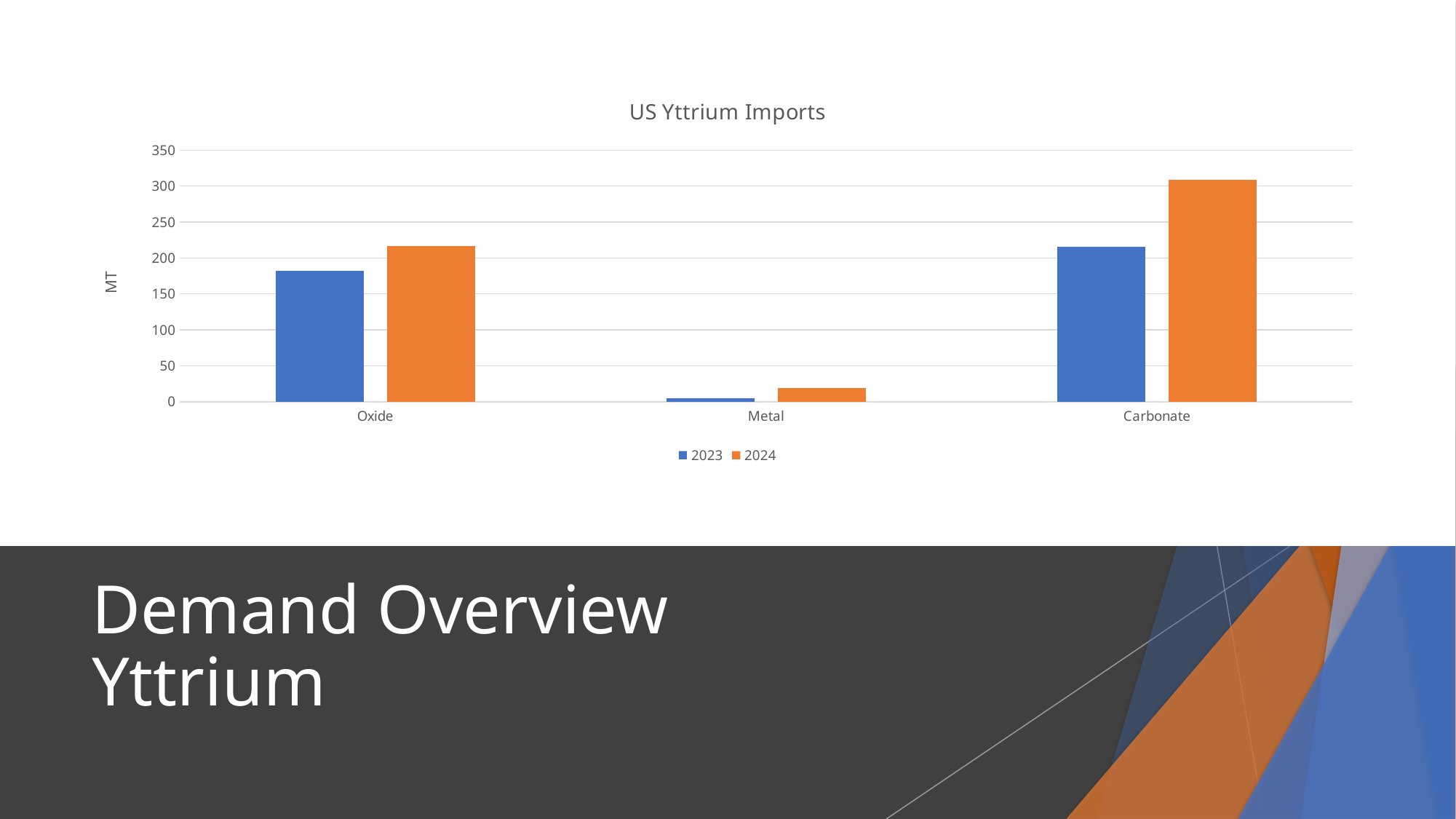
Is the 2023 value for Oxide greater or less than 200? less How many series does the legend of the US Yttrium Imports chart list? 2 Is the 2024 value for Carbonate greater or less than 250? greater For Oxide, which year has the larger value, 2023 or 2024? 2024 How many categories are shown on the x axis of the US Yttrium Imports chart? 3 Which colour represents the 2024 series in the US Yttrium Imports chart? Orange What type of chart is shown on the slide? Bar chart Is the 2024 value for Metal greater or less than 50? less Which category has the lowest 2023 value in the US Yttrium Imports chart? Metal For Carbonate, which year has the larger value, 2023 or 2024? 2024 Which category has the highest 2024 value in the US Yttrium Imports chart? Carbonate What is the label on the vertical axis of the US Yttrium Imports chart? MT